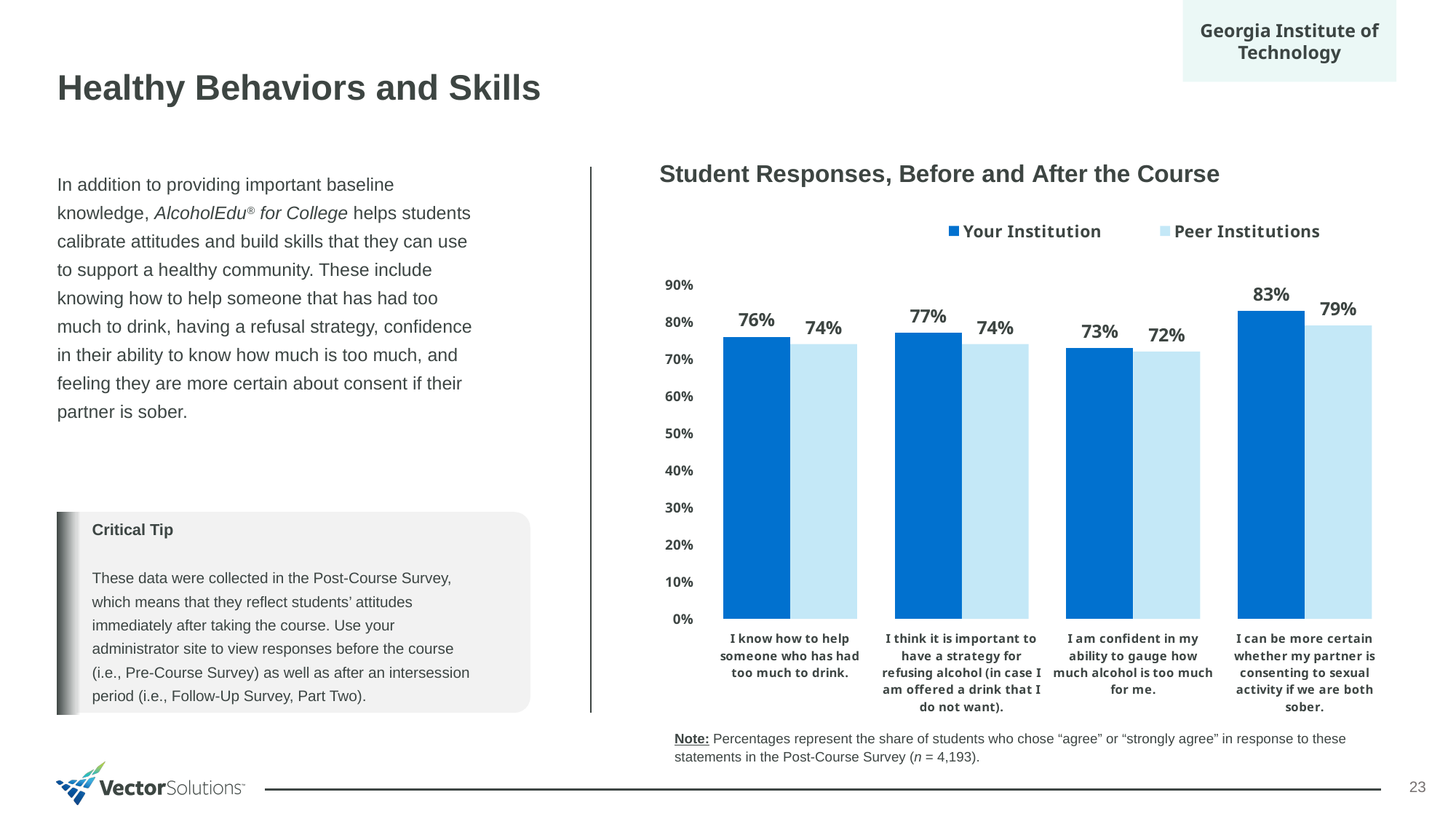
What kind of chart is shown on the slide? Bar chart What is the Peer Institutions value for "I am confident in my ability to gauge how much alcohol is too much for me."? 72% For "I am confident in my ability to gauge how much alcohol is too much for me.", which is larger: Your Institution or Peer Institutions? Your Institution What is the difference between the Your Institution and Peer Institutions values for "I think it is important to have a strategy for refusing alcohol (in case I am offered a drink that I do not want)."? 3% Which statement has the lowest Peer Institutions value? I am confident in my ability to gauge how much alcohol is too much for me. How many statements (categories) are shown on the x axis of the chart? 4 How many series does the chart legend list? 2 What is the Your Institution value for "I can be more certain whether my partner is consenting to sexual activity if we are both sober."? 83% What is the title of the chart? Student Responses, Before and After the Course What is the Your Institution value for "I know how to help someone who has had too much to drink."? 76% What is the difference between the Your Institution and Peer Institutions values for "I can be more certain whether my partner is consenting to sexual activity if we are both sober."? 4% Which statement has the highest Your Institution value? I can be more certain whether my partner is consenting to sexual activity if we are both sober.